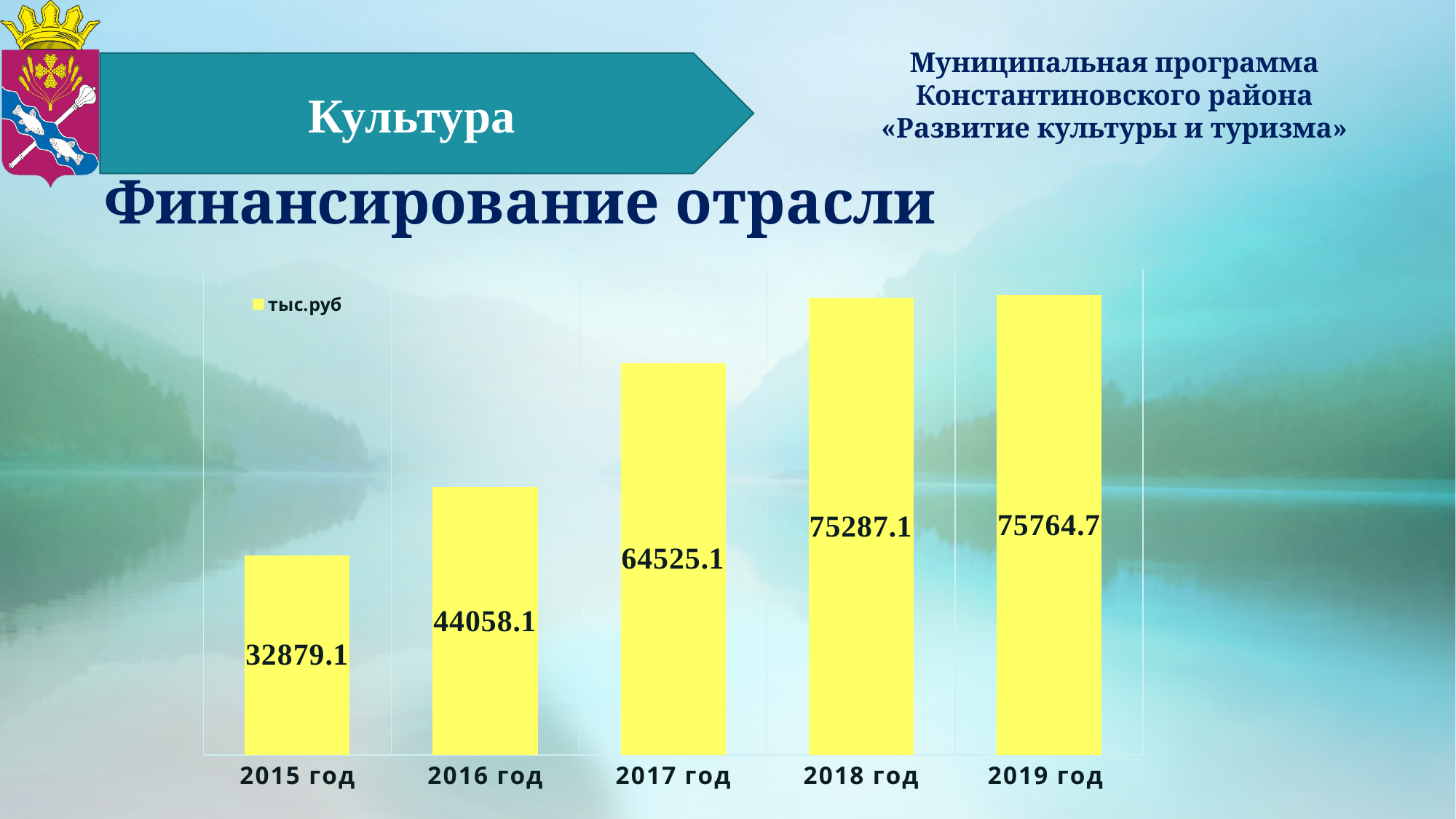
Which is larger, the value for 2017 год or the value for 2016 год? 2017 год Which year has the lowest value? 2015 год Which year has the highest value? 2019 год What is the value for 2019 год? 75764.7 What is the difference between the values for 2019 год and 2018 год? 477.6 What is the difference between the values for 2016 год and 2015 год? 11179.0 What type of chart is shown on the slide? bar chart Do the values rise or fall from 2015 год to 2019 год? rise What unit does the legend give for the series? тыс.руб How many years are shown on the x axis? 5 What is the value for 2015 год? 32879.1 What is the value for 2017 год? 64525.1